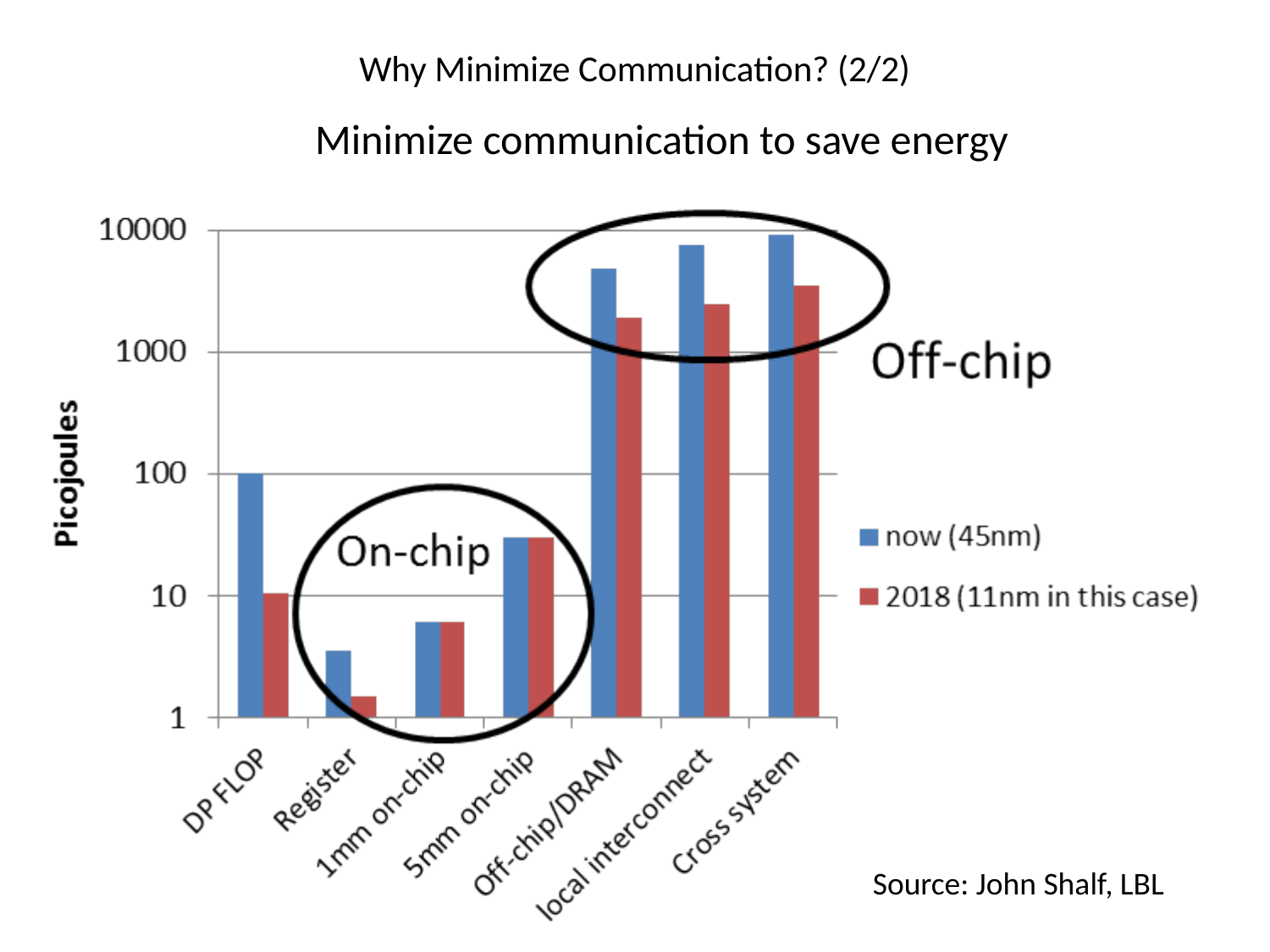
Which category has the highest value for the now (45nm) series? Cross system How many categories are shown on the x axis of the chart? 7 Is the 2018 (11nm in this case) value for 1mm on-chip greater or less than 10? less For DP FLOP, which series has the larger value: now (45nm) or 2018 (11nm in this case)? now (45nm) Is the now (45nm) value for Off-chip/DRAM greater or less than 1000? greater Which category has the lowest value for the 2018 (11nm in this case) series? Register Is the now (45nm) value for Register greater or less than 10? less How many series does the chart's legend list? 2 What kind of chart is shown on the slide? bar chart What is the label on the y axis of the chart? Picojoules What are the two series named in the chart's legend? now (45nm) and 2018 (11nm in this case)